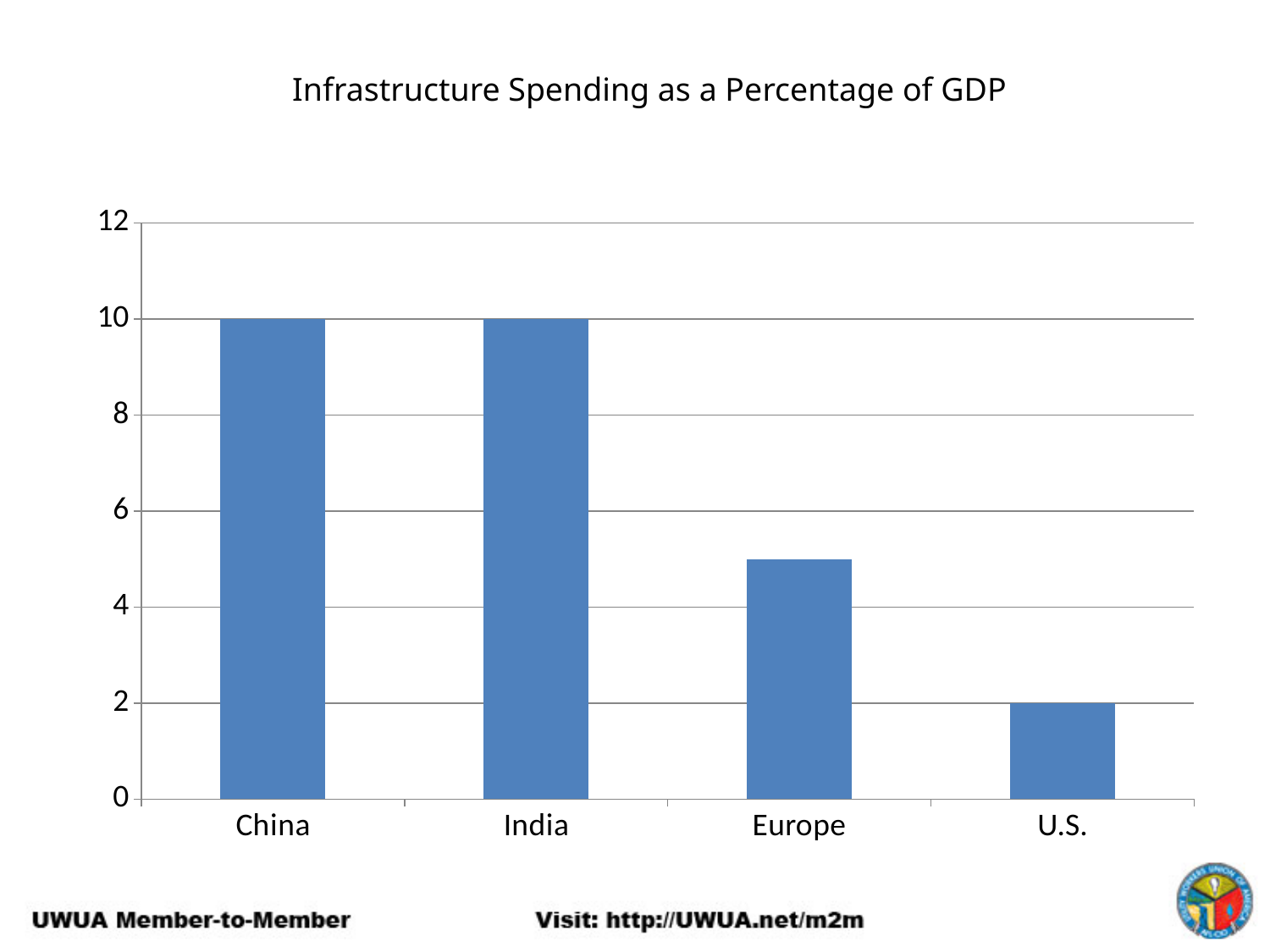
How many categories are shown on the x axis? 4 Which category has the lowest value? U.S. What is the value for U.S.? 2 Is the value for Europe greater or less than 6? less What is the title of the chart? Infrastructure Spending as a Percentage of GDP Is the value for Europe greater or less than 4? greater What is the value for India? 10 What is the value for China? 10 What is the difference between the values for China and U.S.? 8 Do the values rise or fall moving from China to U.S. along the x axis? fall What kind of chart is shown on the slide? bar chart Which is larger, the value for India or the value for Europe? India